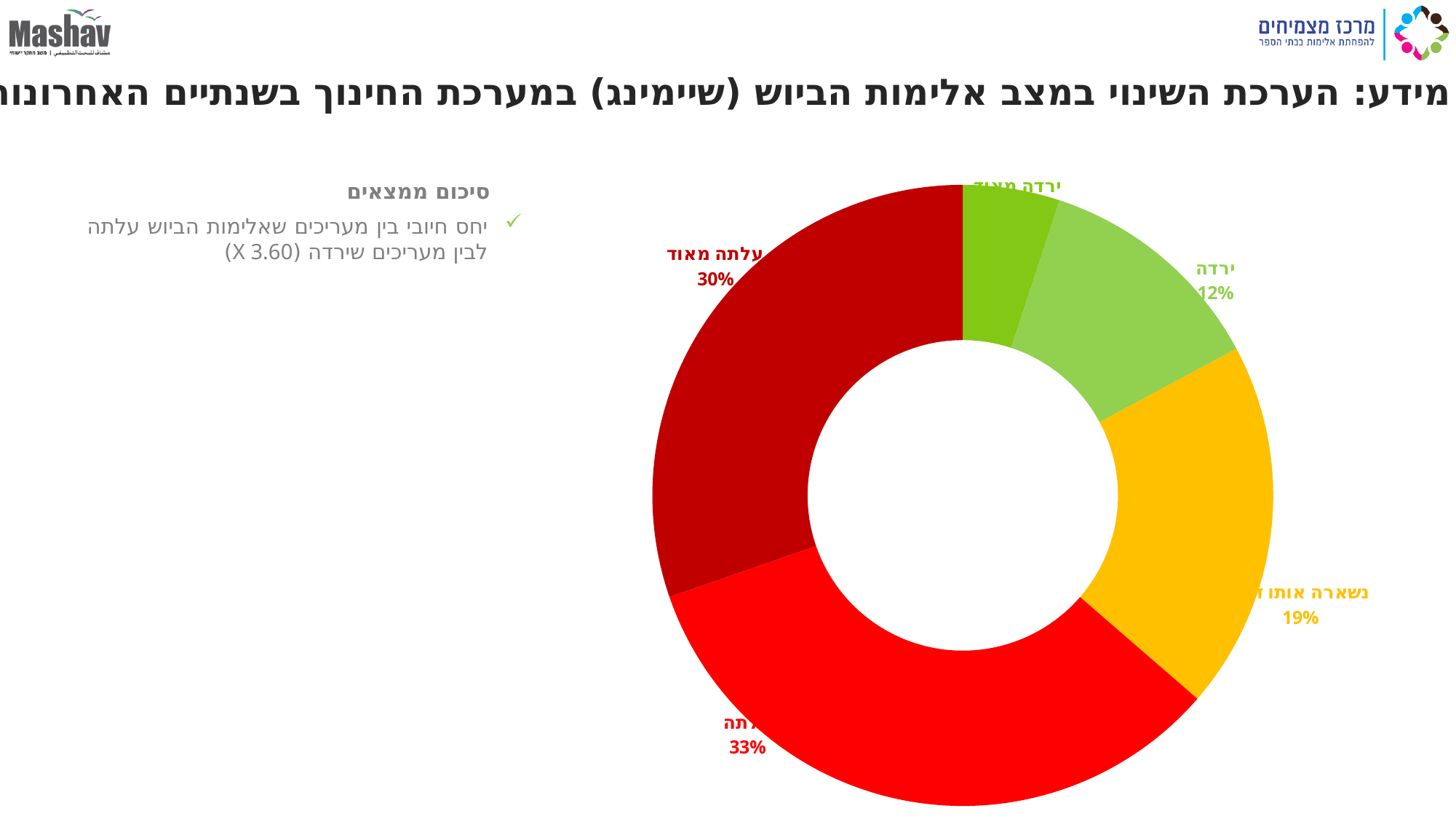
What percentage is shown for the slice labelled עלתה מאוד? 30% What kind of chart is shown on the slide? Donut (pie) chart What percentage is shown for the bright red slice at the bottom of the donut? 33% What percentage is shown for the yellow slice (נשארה אותו דבר)? 19% What colour is the slice labelled עלתה מאוד? Dark red How many slices does the donut chart have? 5 What is the largest percentage printed on the donut chart? 33% What is the difference in percentage points between the yellow slice (19%) and the ירדה slice (12%)? 7 percentage points What percentage is shown for the slice labelled ירדה? 12% Which slice of the donut chart is the smallest? ירדה מאוד What is the difference in percentage points between the עלתה מאוד slice (30%) and the ירדה slice (12%)? 18 percentage points Which is larger, the slice for עלתה מאוד or the slice for ירדה? עלתה מאוד